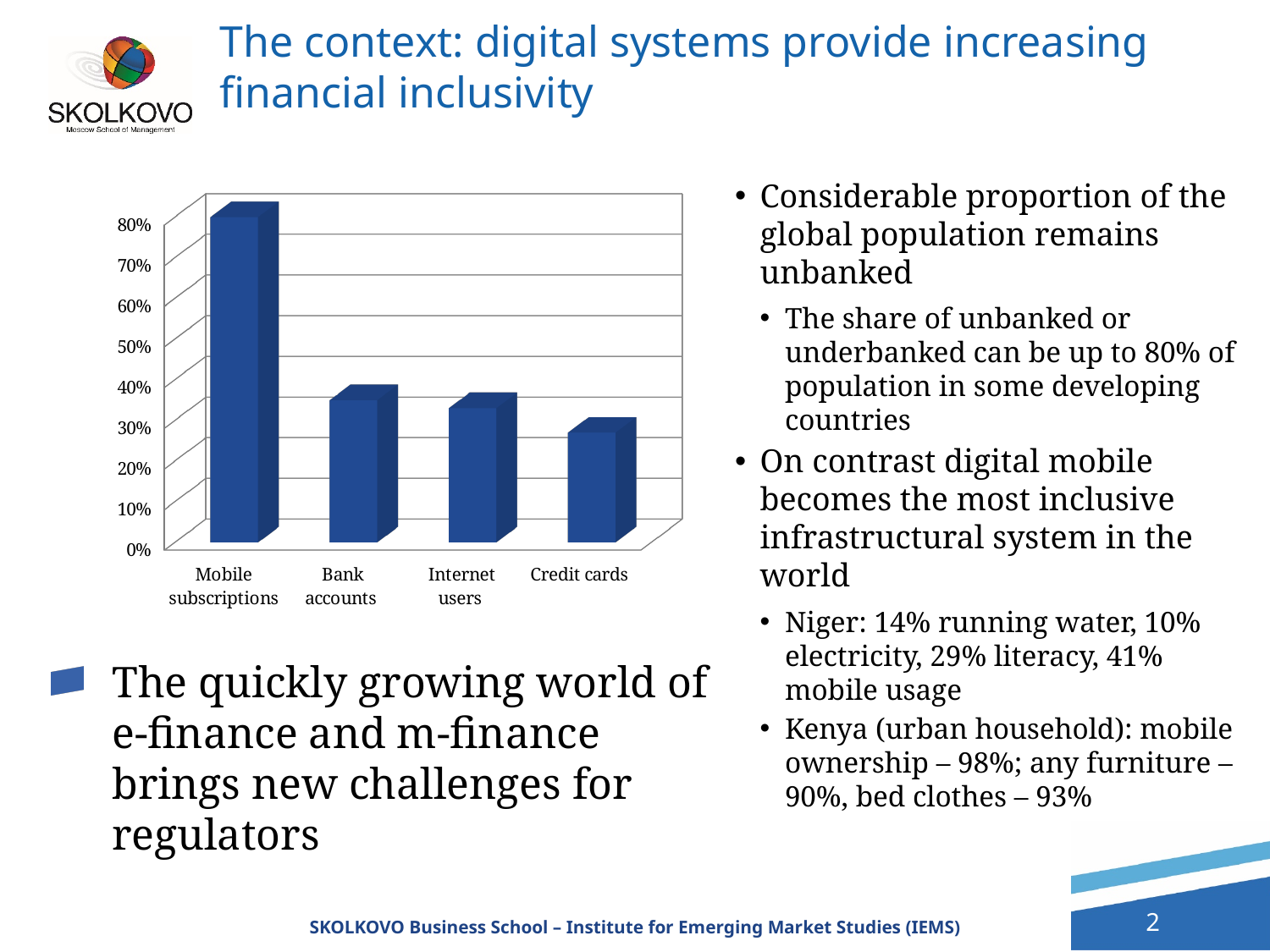
Is the value for Bank accounts greater or less than 40%? less Is the value for Credit cards greater or less than 20%? greater Is the value for Mobile subscriptions greater or less than 70%? greater Which category has the lowest value in the chart? Credit cards Which category has the highest value in the chart? Mobile subscriptions Do the values in the chart generally rise or fall from left to right along the x axis? fall What kind of chart is shown on the slide? bar chart How many categories are shown on the x axis of the chart? 4 Which is larger, the value for Mobile subscriptions or the value for Credit cards? Mobile subscriptions